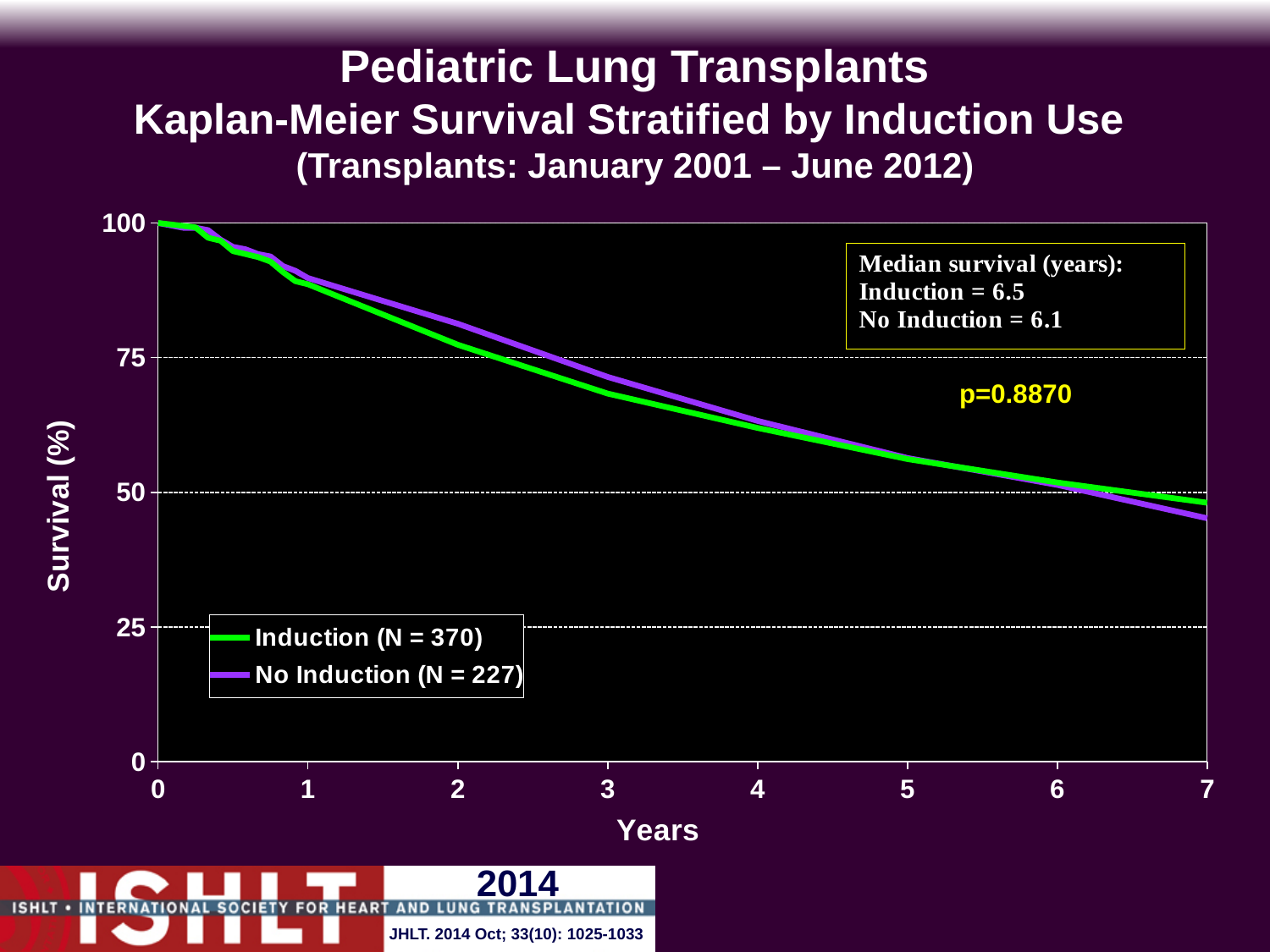
What is the p-value shown on the chart? p=0.8870 What colour is the line for the No Induction group? purple Is the survival value for the Induction group at 3 years greater or less than 75? less What is the N for the Induction group in the legend? 370 Which group has the longer median survival, Induction or No Induction? Induction What kind of chart is shown on the slide? line chart What is the median survival in years for the No Induction group? 6.1 Is the survival value for the No Induction group at 7 years greater or less than 50? less How many series does the legend list? 2 What is the difference in median survival (years) between the Induction and No Induction groups? 0.4 Do the survival curves rise or fall as years increase? fall What is the median survival in years for the Induction group? 6.5